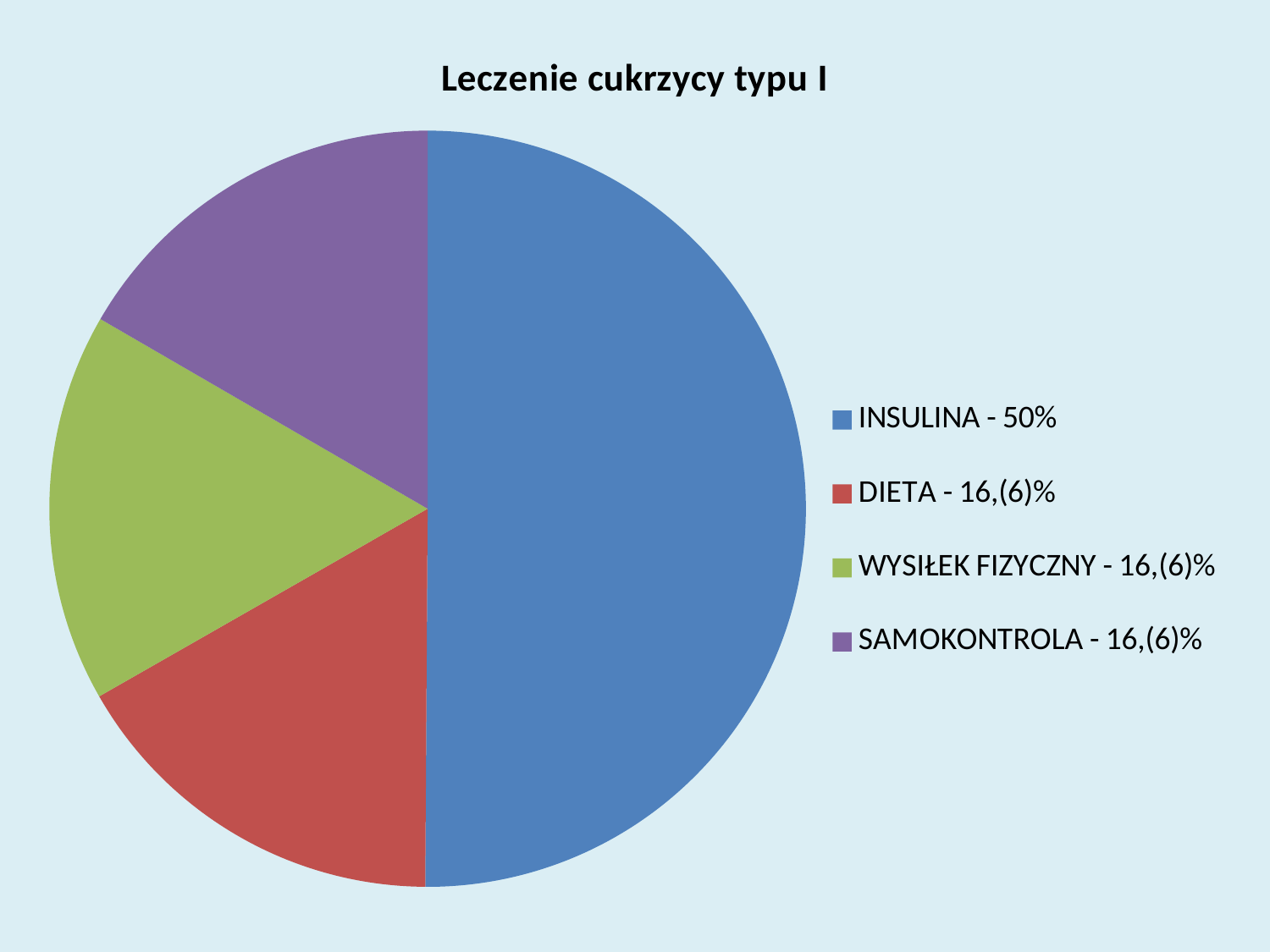
What share of the pie does WYSIŁEK FIZYCZNY take? 16,(6)% Which is larger, the slice for INSULINA or the slice for DIETA? INSULINA How many slices does the pie chart have? 4 What share of the pie does DIETA take? 16,(6)% Which category has the largest slice of the pie? INSULINA What kind of chart is shown on the slide? pie chart How many entries does the legend list? 4 What share of the pie does INSULINA take? 50% What is the title of the chart? Leczenie cukrzycy typu I Which colour represents INSULINA in the legend? blue